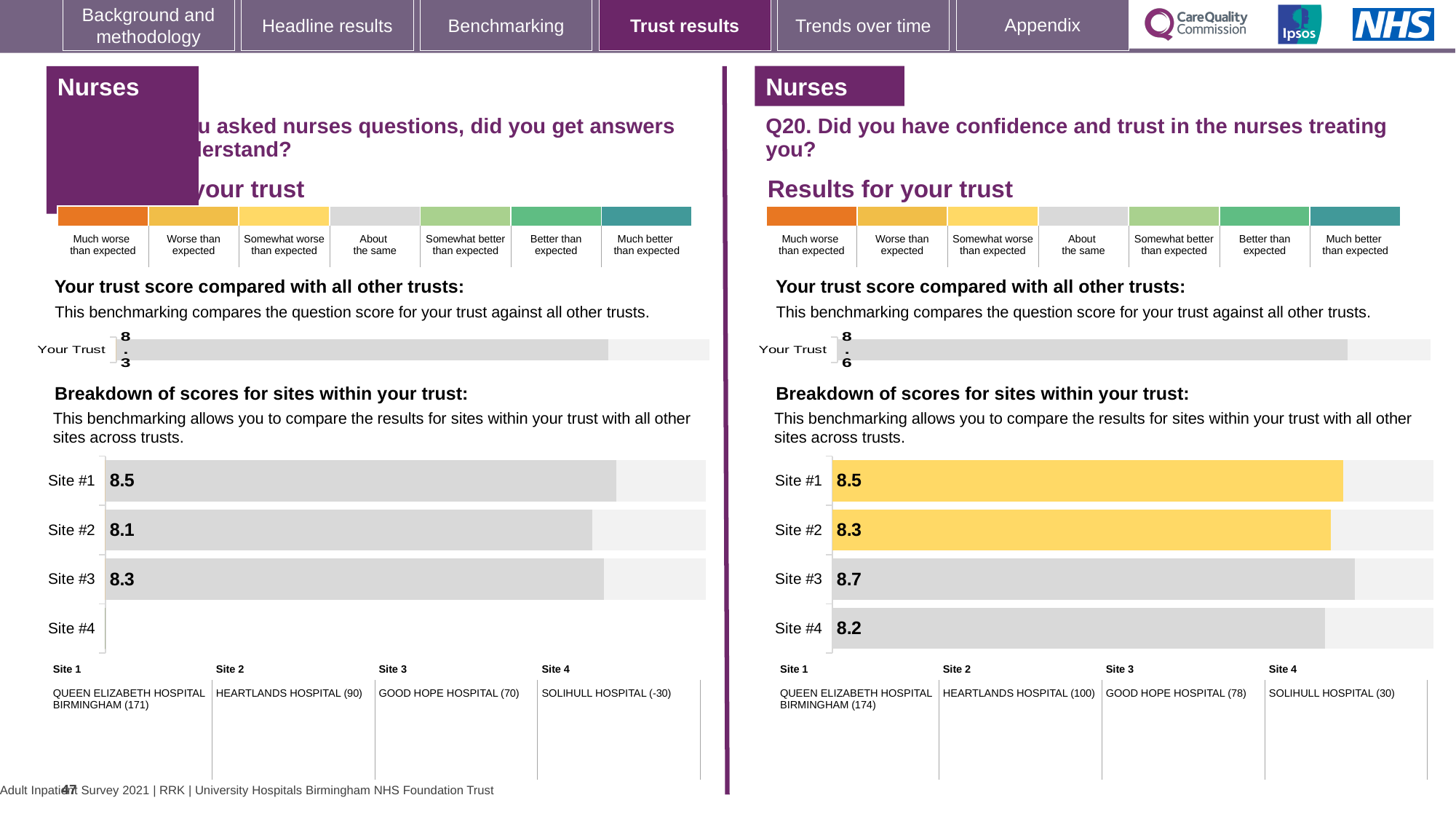
In the left-hand site breakdown chart, what is the score for Site #2? 8.1 In the right-hand site breakdown chart (Q20, confidence and trust in nurses), what is the score for Site #3? 8.7 In the left-hand 'Your Trust' chart, what is the trust score shown? 8.3 Comparing the two 'Your Trust' charts, is the trust score higher for the left-hand question or the right-hand question (Q20)? Right-hand question (Q20) In the right-hand site breakdown chart (Q20), which site has the highest score? Site #3 In the right-hand site breakdown chart (Q20), which site has the lowest score? Site #4 How many site categories are listed on the axis of the right-hand site breakdown chart (Q20)? 4 What type of chart is used for the site breakdown of scores on the right-hand side (Q20)? Bar chart In the right-hand site breakdown chart (Q20), what is the difference between the scores for Site #3 and Site #4? 0.5 In the left-hand site breakdown chart, which site has the highest score? Site #1 In the right-hand 'Your Trust' chart (Q20), what is the trust score shown? 8.6 In the left-hand site breakdown chart, what is the difference between the scores for Site #1 and Site #2? 0.4